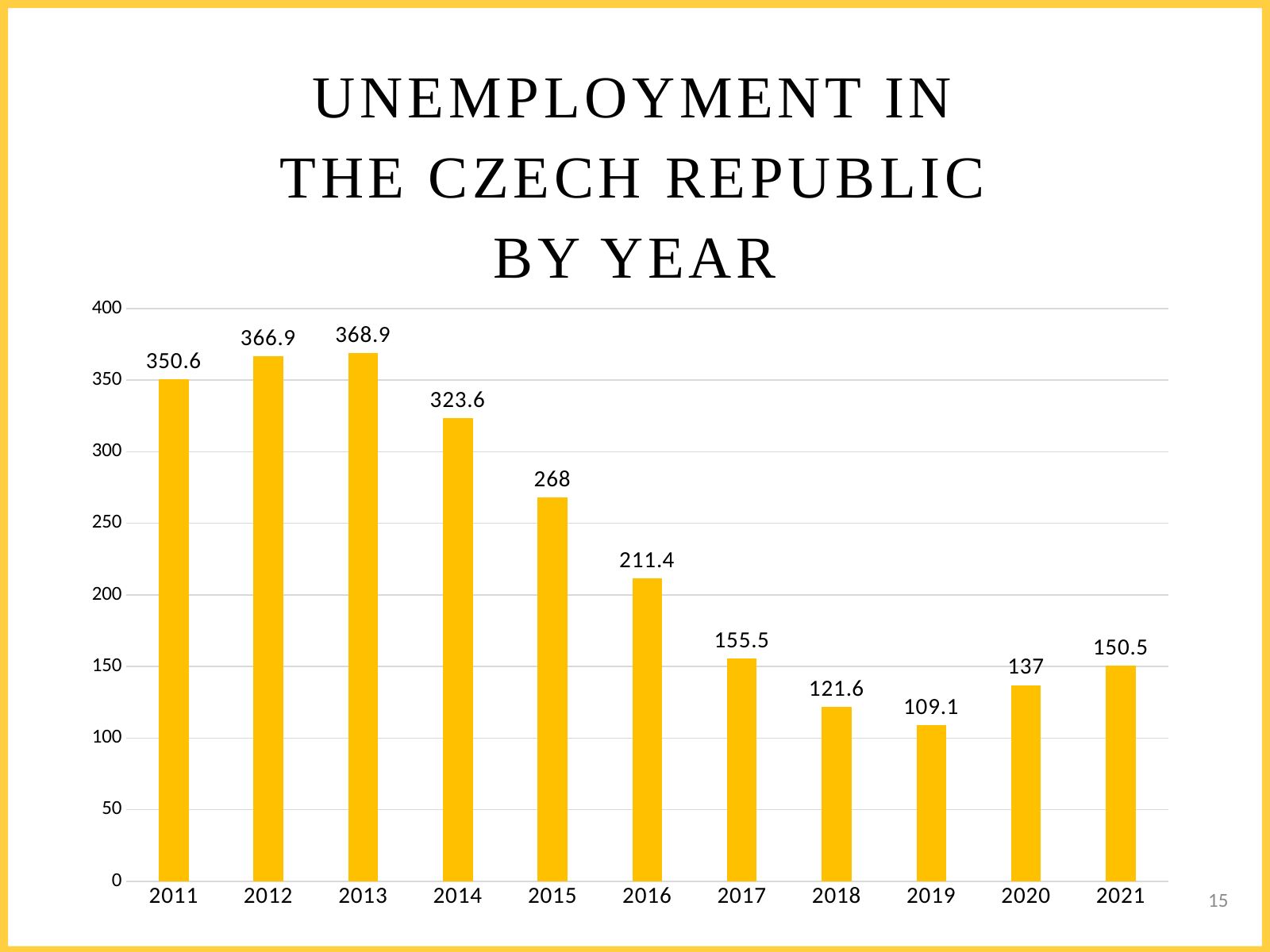
Which year has the lowest value? 2019 Which is larger, the value for 2017 or the value for 2021? 2017 What kind of chart is shown on the slide? bar chart What is the difference between the values for 2015 and 2016? 56.6 How many years are shown on the x axis? 11 Is the value for 2018 greater or less than 150? less What is the value for 2019? 109.1 What is the difference between the values for 2020 and 2019? 27.9 Do the values generally rise or fall from 2013 to 2019? fall What is the value for 2014? 323.6 Which year has the highest value? 2013 What is the value for 2021? 150.5